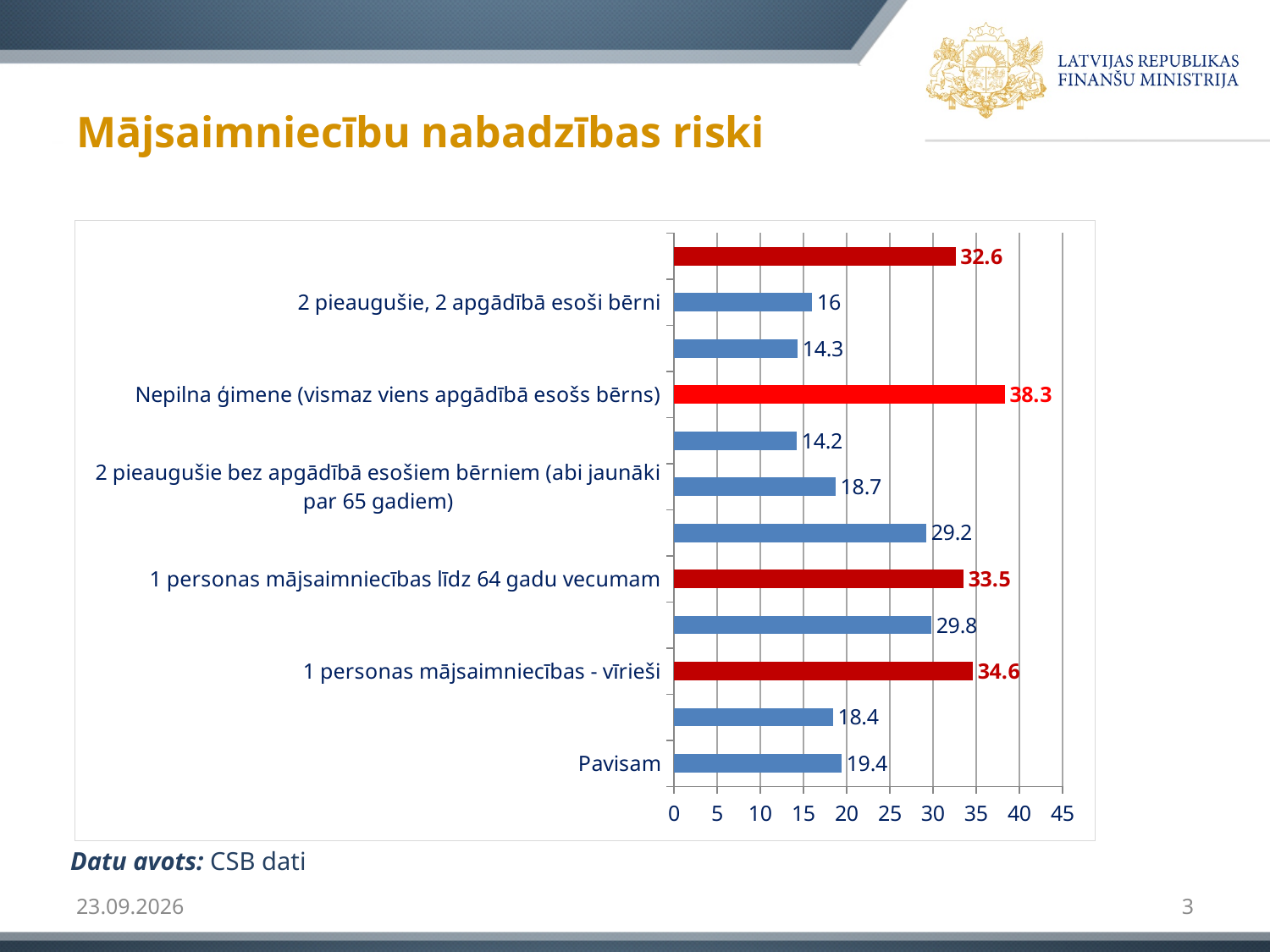
How many bars are plotted on the chart? 12 Which labelled category has the highest value? Nepilna ģimene (vismaz viens apgādībā esošs bērns) What is the title of the slide containing the chart? Mājsaimniecību nabadzības riski What is the value for "Pavisam"? 19.4 What is the lowest value shown on the chart? 14.2 What is the value for "Nepilna ģimene (vismaz viens apgādībā esošs bērns)"? 38.3 What is the value for "2 pieaugušie, 2 apgādībā esoši bērni"? 16 Which is larger: the value for "1 personas mājsaimniecības līdz 64 gadu vecumam" or the value for "1 personas mājsaimniecības - vīrieši"? 1 personas mājsaimniecības - vīrieši What is the value for "1 personas mājsaimniecības - vīrieši"? 34.6 What is the difference between the value for "Nepilna ģimene (vismaz viens apgādībā esošs bērns)" and the value for "Pavisam"? 18.9 What kind of chart is shown on the slide? bar chart What is the difference between the value for "1 personas mājsaimniecības - vīrieši" and the value for "2 pieaugušie bez apgādībā esošiem bērniem (abi jaunāki par 65 gadiem)"? 15.9